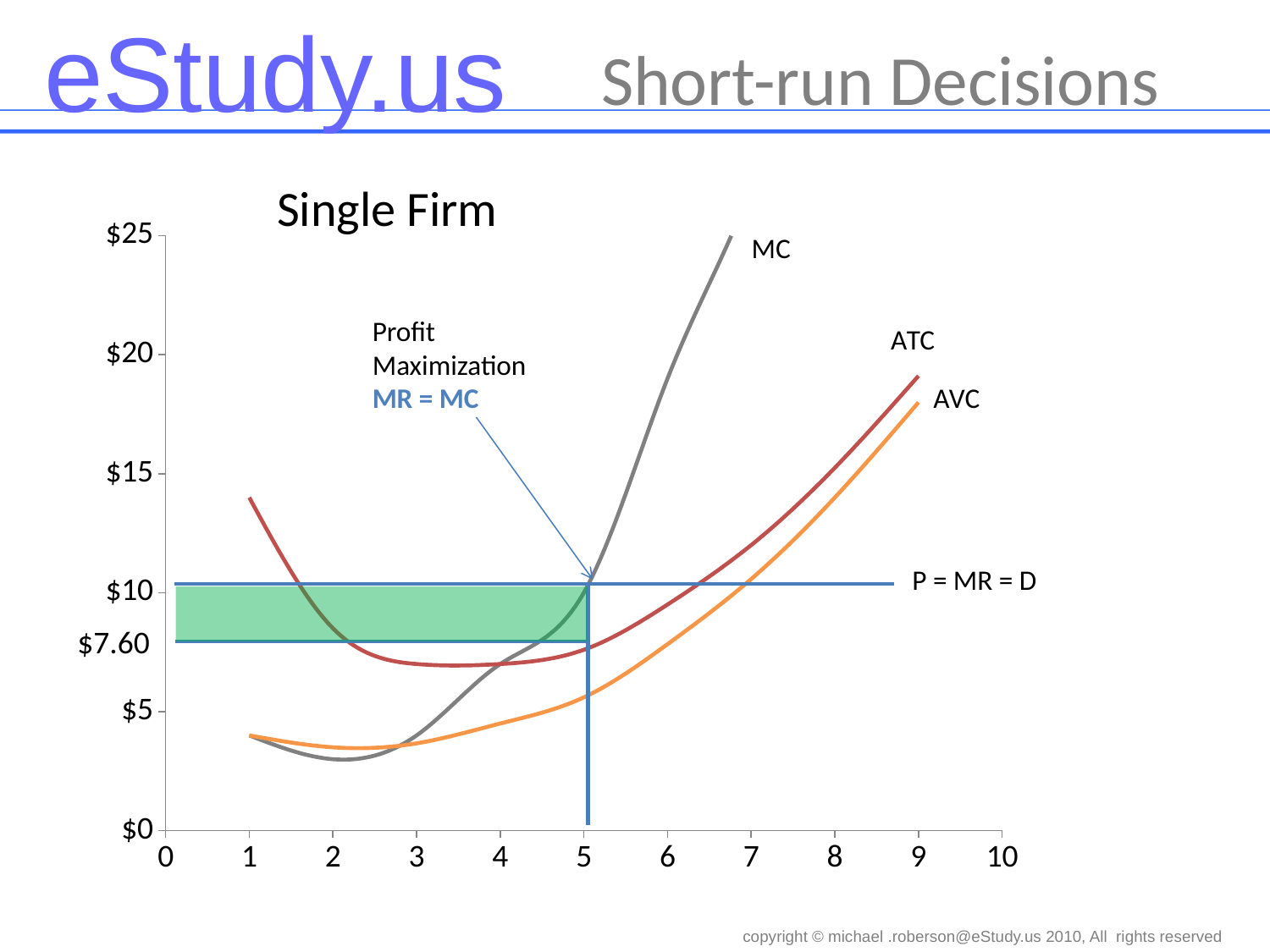
At what quantity does the chart mark profit maximization (MR = MC)? 5 At a quantity of 7, which is higher, ATC or AVC? ATC Does the MC curve rise or fall between quantities 3 and 7? rise What is the value of ATC at a quantity of 5, as labeled on the y-axis? $7.60 What is the title of the chart? Single Firm Which curve is lowest at a quantity of 4? AVC What label is given to the horizontal line at about $10? P = MR = D Which curve reaches the highest value on the chart? MC How many labeled curves or lines are plotted on the chart? 4 Is the value of MC at a quantity of 6 greater or less than $15? greater Is the value of AVC at a quantity of 5 greater or less than $10? less What kind of chart is shown on the slide? line chart